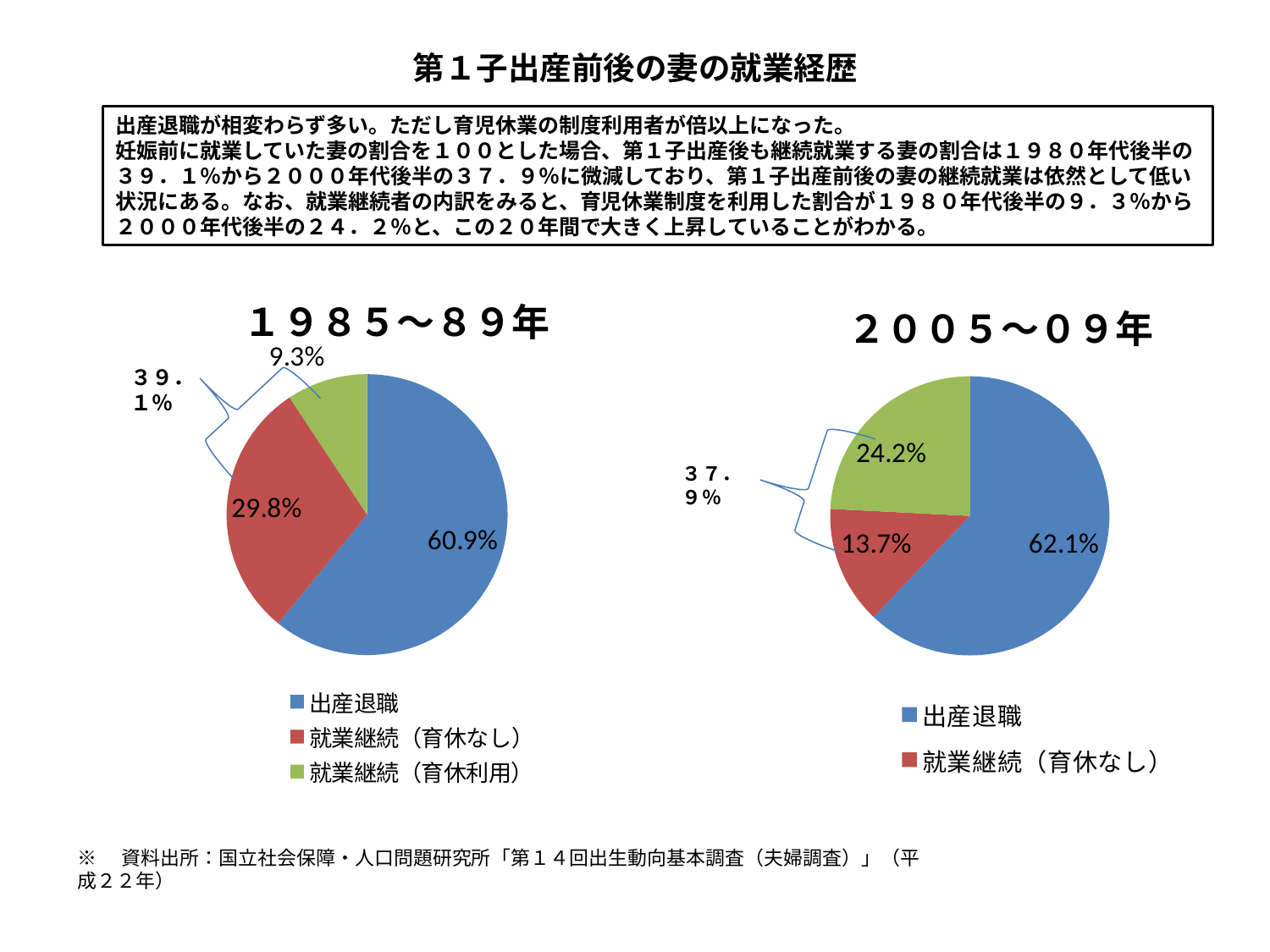
What kind of chart is the "1985～89年" chart? pie chart In the "1985～89年" chart, what is the share for 就業継続（育休なし）? 29.8% How many entries does the legend of the "1985～89年" chart list? 3 In the "2005～09年" chart, which category has the largest slice? 出産退職 In the "1985～89年" chart, what is the difference between 出産退職 and 就業継続（育休なし）? 31.1% In the "1985～89年" chart, what is the share for 就業継続（育休利用）? 9.3% In the "2005～09年" chart, what is the share for 出産退職? 62.1% In the "1985～89年" chart, what is the share for 出産退職? 60.9% In the "1985～89年" chart, which category has the smallest slice? 就業継続（育休利用） In the "2005～09年" chart, what is the share shown on the green slice? 24.2% In the "2005～09年" chart, what is the share for 就業継続（育休なし）? 13.7% Which is larger: 出産退職 in the "1985～89年" chart or 出産退職 in the "2005～09年" chart? 2005～09年